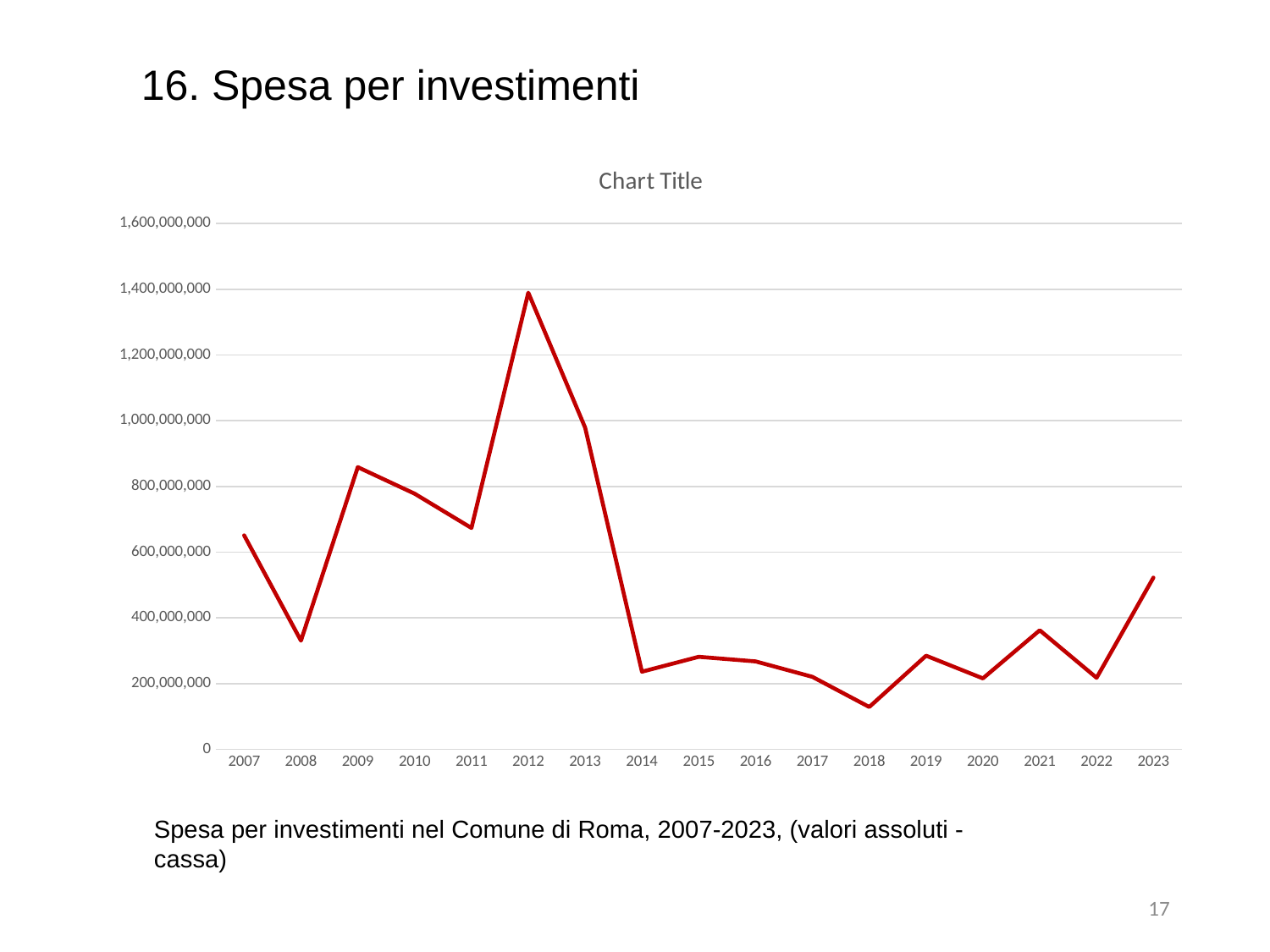
What kind of chart is shown on the slide? line chart Does the value rise or fall from 2012 to 2014? fall Is the value for 2023 greater or less than 600,000,000? less Which year has the larger value, 2021 or 2022? 2021 How many years are plotted along the x axis of the chart? 17 Which year has the lowest value in the chart? 2018 Which year has the larger value, 2013 or 2014? 2013 Is the value for 2012 greater or less than 1,200,000,000? greater Is the value for 2009 greater or less than 800,000,000? greater Which year has the highest value in the chart? 2012 What is the title printed above the chart? Chart Title